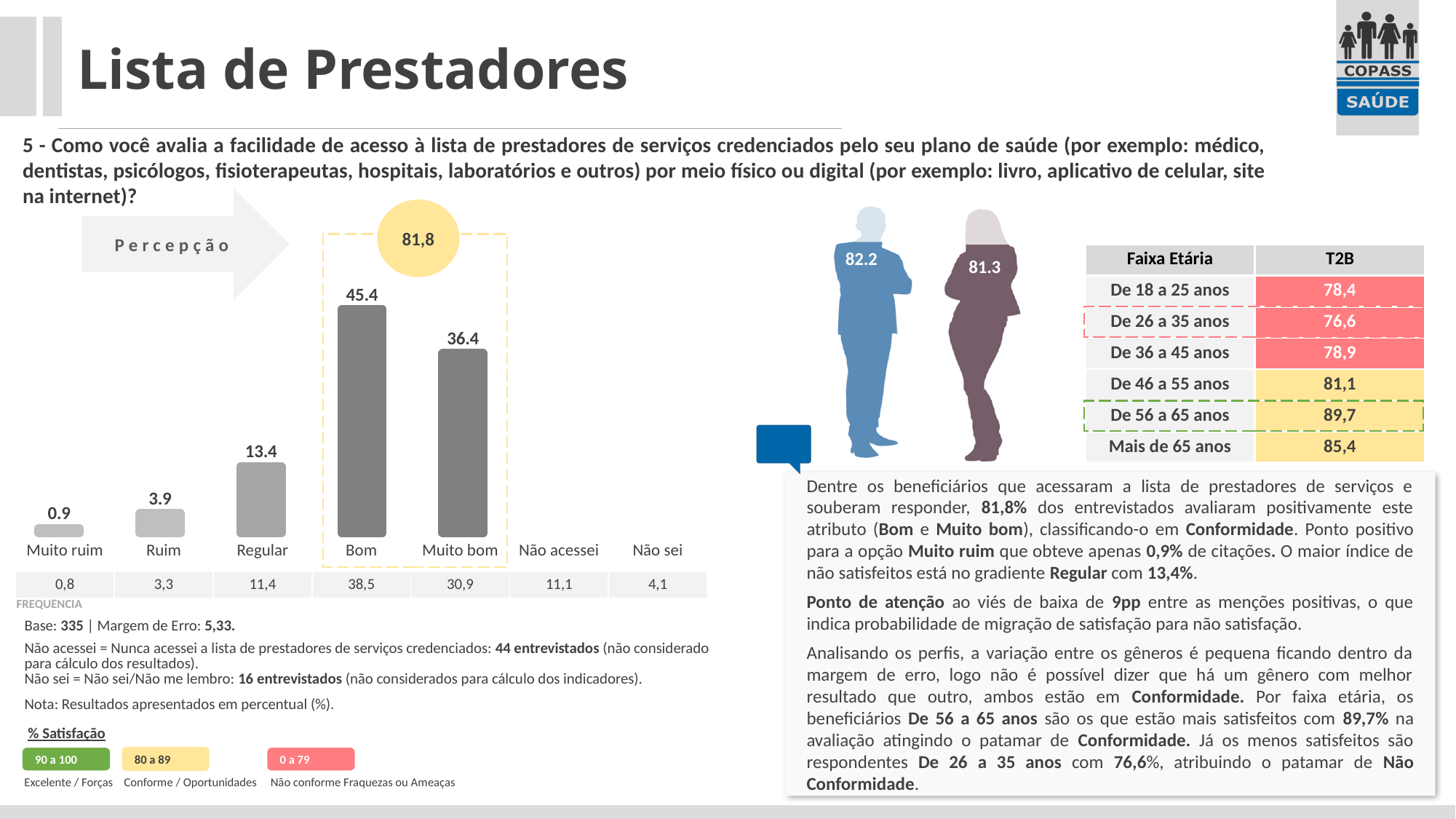
What is the value shown for the Bom bar in the bar chart? 45.4 Which is larger in the bar chart, the value for Ruim or the value for Regular? Regular How many category labels appear along the x axis of the bar chart? 7 What type of chart is used to show the Percepção results? Bar chart What is the combined value of the Bom and Muito bom bars, as shown in the circle above the dashed box? 81,8 What is the difference between the Bom and Muito bom values in the bar chart? 9 What is the value shown for the Regular bar in the bar chart? 13.4 Among the categories with bars, which has the lowest value in the bar chart? Muito ruim Which category has the highest bar in the bar chart? Bom What is the value shown for the Muito ruim bar in the bar chart? 0.9 What is the value shown for the Muito bom bar in the bar chart? 36.4 What is the FREQUENCIA value shown below the Não acessei category? 11,1